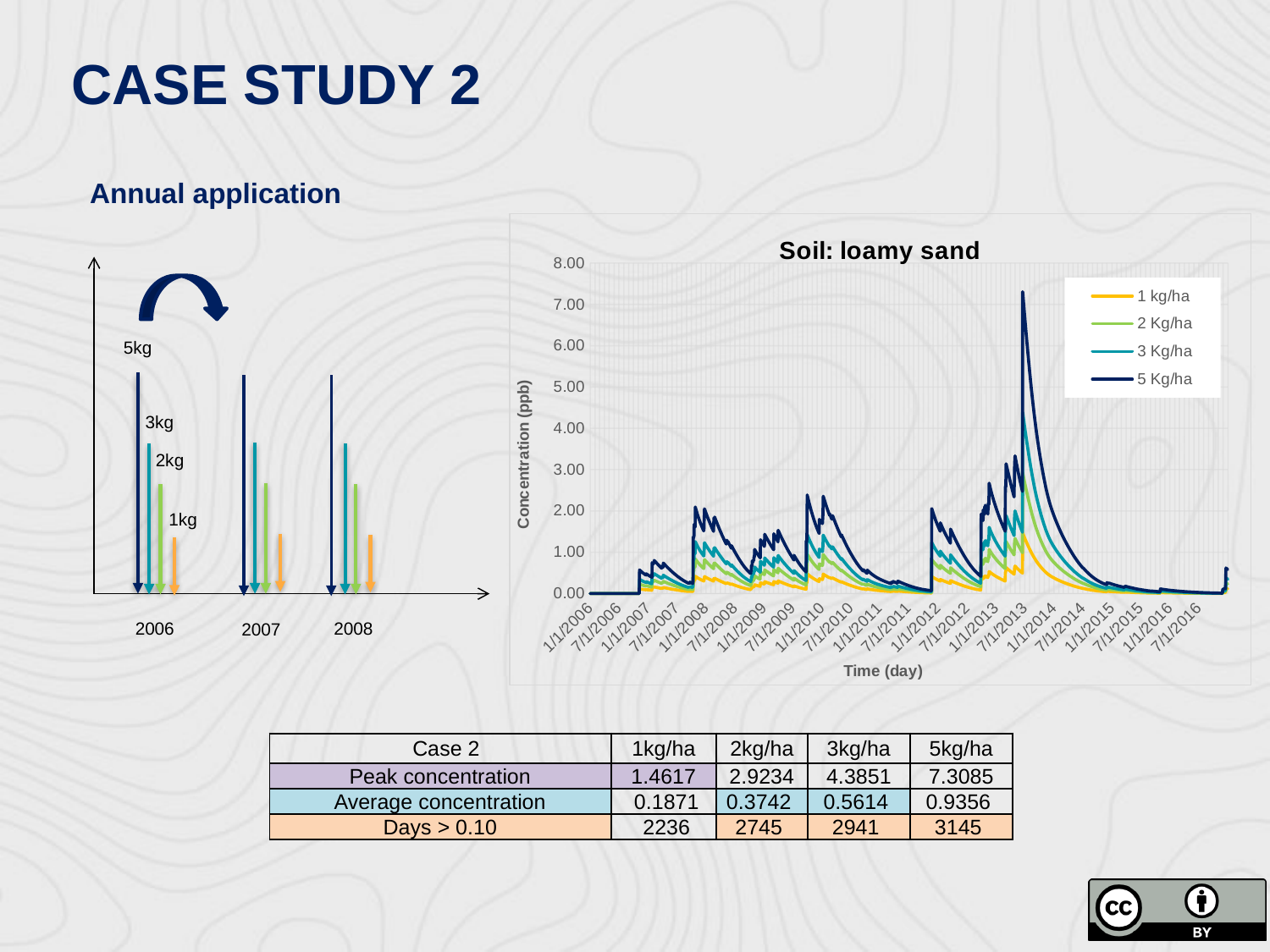
In the "Soil: loamy sand" chart, is the highest peak of the 2 Kg/ha series greater or less than 2.00? greater In the "Soil: loamy sand" chart, is the highest peak of the 5 Kg/ha series greater or less than 7.00? greater In the "Soil: loamy sand" chart, which series stays lowest throughout the period? 1 kg/ha What is the label of the vertical axis of the "Soil: loamy sand" chart? Concentration (ppb) What is the title of the line chart on the slide? Soil: loamy sand In the "Soil: loamy sand" chart, is the highest peak of the 1 kg/ha series greater or less than 2.00? less In the "Soil: loamy sand" chart, which series has the larger peak in 2013: 5 Kg/ha or 2 Kg/ha? 5 Kg/ha How many series does the legend of the "Soil: loamy sand" chart list? 4 In the "Soil: loamy sand" chart, do the concentrations rise or fall between 7/1/2013 and 1/1/2015? fall In the "Soil: loamy sand" chart, which series reaches the highest concentration? 5 Kg/ha What kind of chart is shown under the title "Soil: loamy sand"? line chart